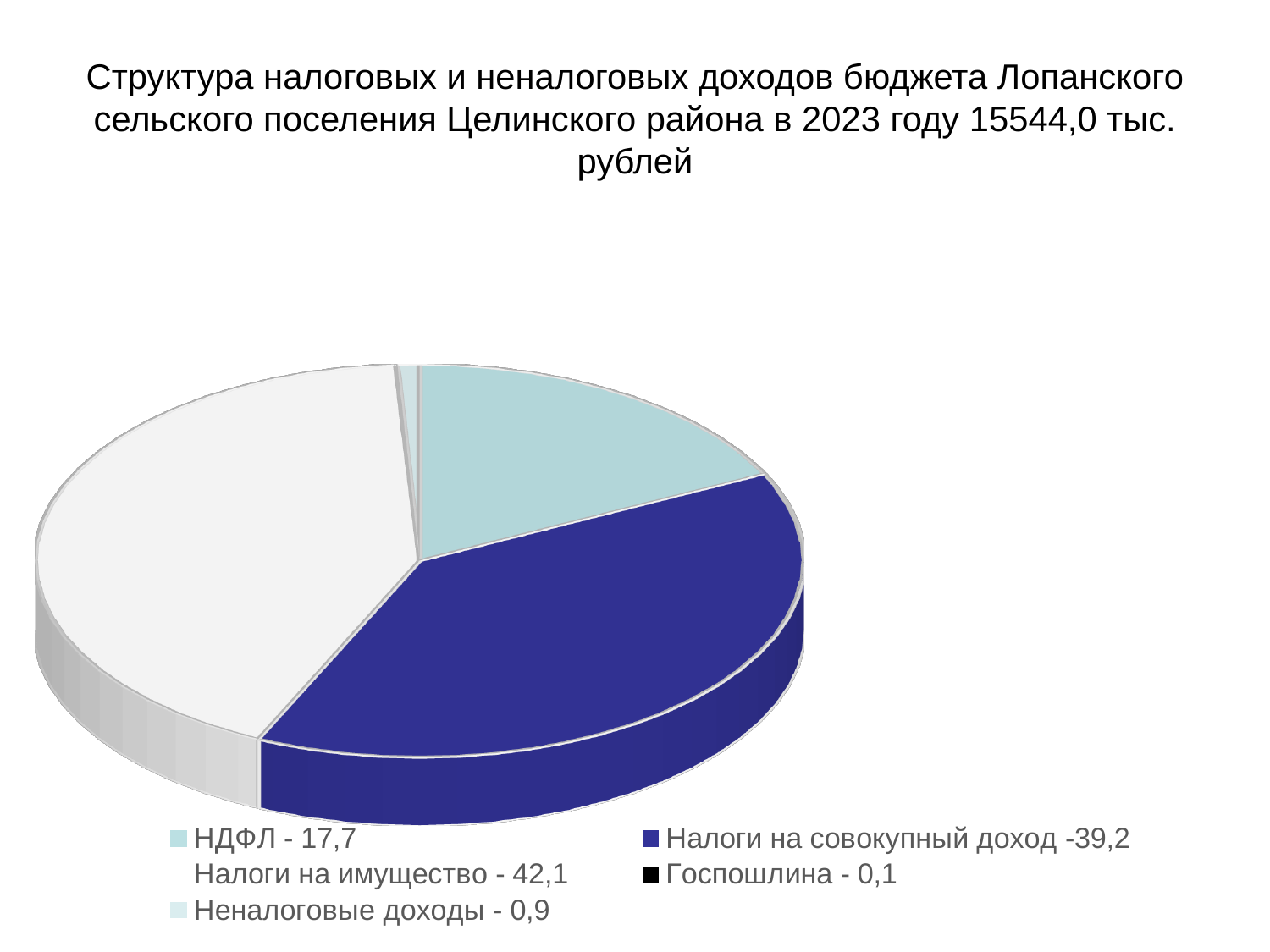
How many categories does the legend of the pie chart list? 5 What is the difference between the values for Налоги на имущество and Налоги на совокупный доход? 2,9 What value is given for Неналоговые доходы in the legend? 0,9 What value is given for НДФЛ in the legend? 17,7 What value is given for Налоги на имущество in the legend? 42,1 What value is given for Госпошлина in the legend? 0,1 What kind of chart is shown on the slide? pie chart Which category has the smallest share of the pie? Госпошлина Which is larger, the share for Налоги на совокупный доход or the share for НДФЛ? Налоги на совокупный доход What total amount in thousand rubles is stated in the chart title? 15544,0 тыс. рублей Which category has the largest share of the pie? Налоги на имущество What value is given for Налоги на совокупный доход in the legend? 39,2